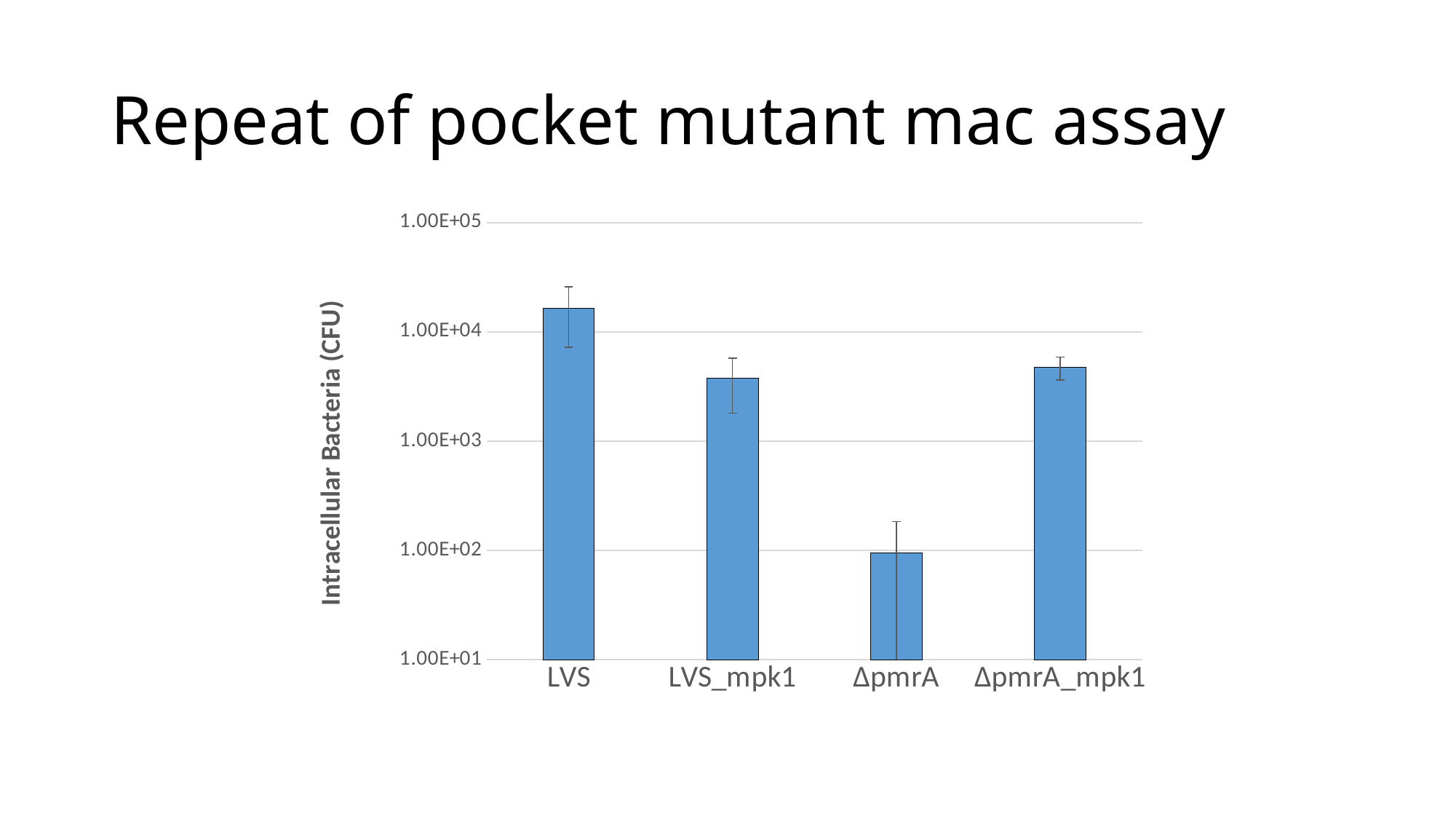
Is the value for ΔpmrA_mpk1 greater or less than 1.00E+03? greater Is the value for ΔpmrA greater or less than 1.00E+03? less Is the value for LVS greater or less than 1.00E+04? greater What is the title of the slide? Repeat of pocket mutant mac assay Which category has the lowest intracellular bacteria count? ΔpmrA What is the label of the y axis? Intracellular Bacteria (CFU) Which is larger, the value for ΔpmrA or the value for ΔpmrA_mpk1? ΔpmrA_mpk1 How many categories are plotted on the x axis? 4 What kind of chart is shown on the slide? bar chart Which category has the highest intracellular bacteria count? LVS Which is larger, the value for LVS or the value for LVS_mpk1? LVS